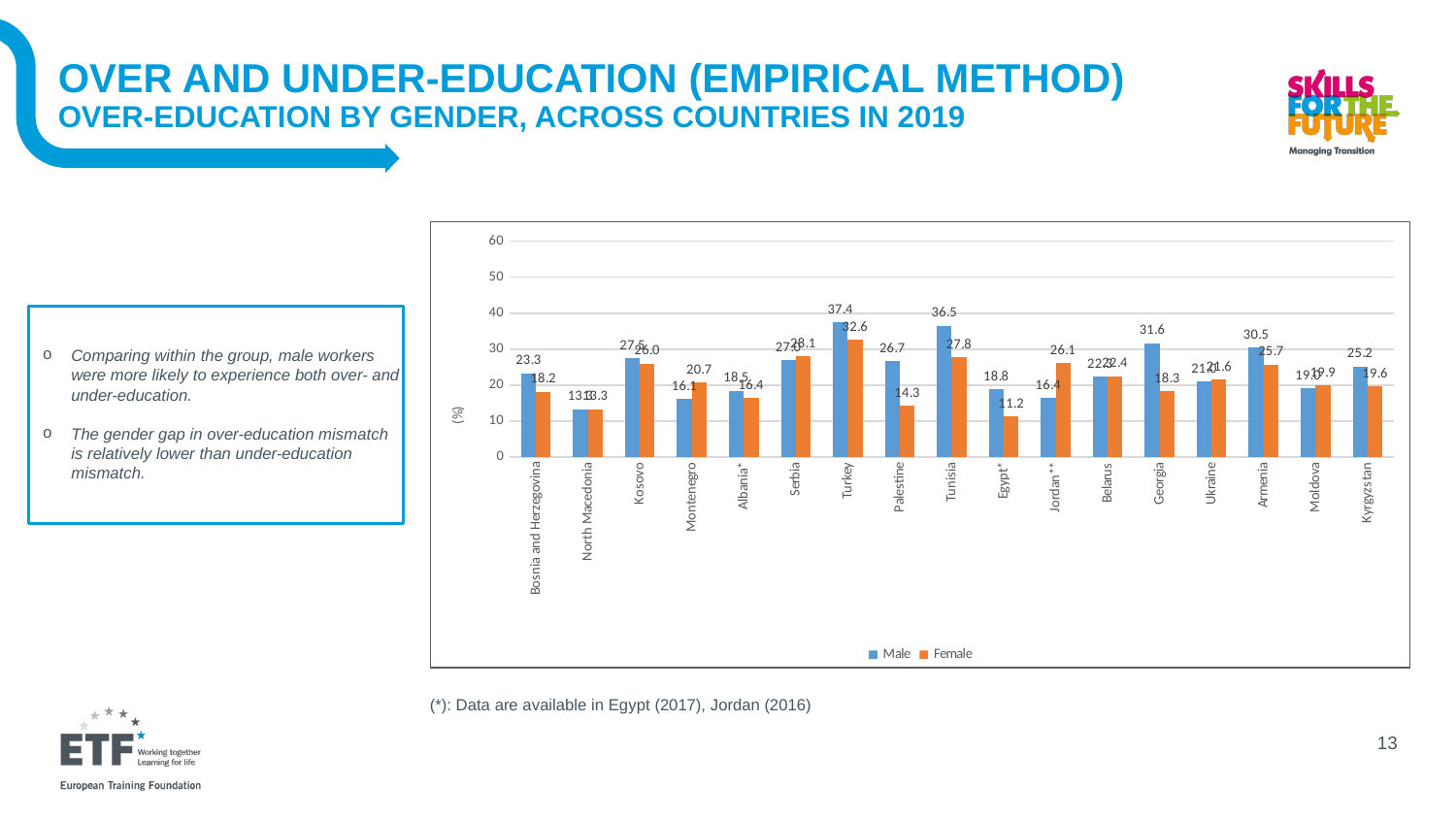
Which country has the highest Male value in the chart? Turkey What type of chart is shown on the slide? Bar chart What is the Female over-education value for Egypt*? 11.2 What label is shown on the y axis of the chart? (%) What is the difference between the Male and Female values for Palestine? 12.4 What is the Female value for Montenegro? 20.7 What is the Male over-education value for Turkey? 37.4 Is the Male value for Belarus greater or less than 30? less For Jordan**, which is larger, the Male or the Female value? Female How many countries are shown on the x axis of the chart? 17 Which country has the lowest Female value in the chart? Egypt* How many series does the legend list in the chart? 2